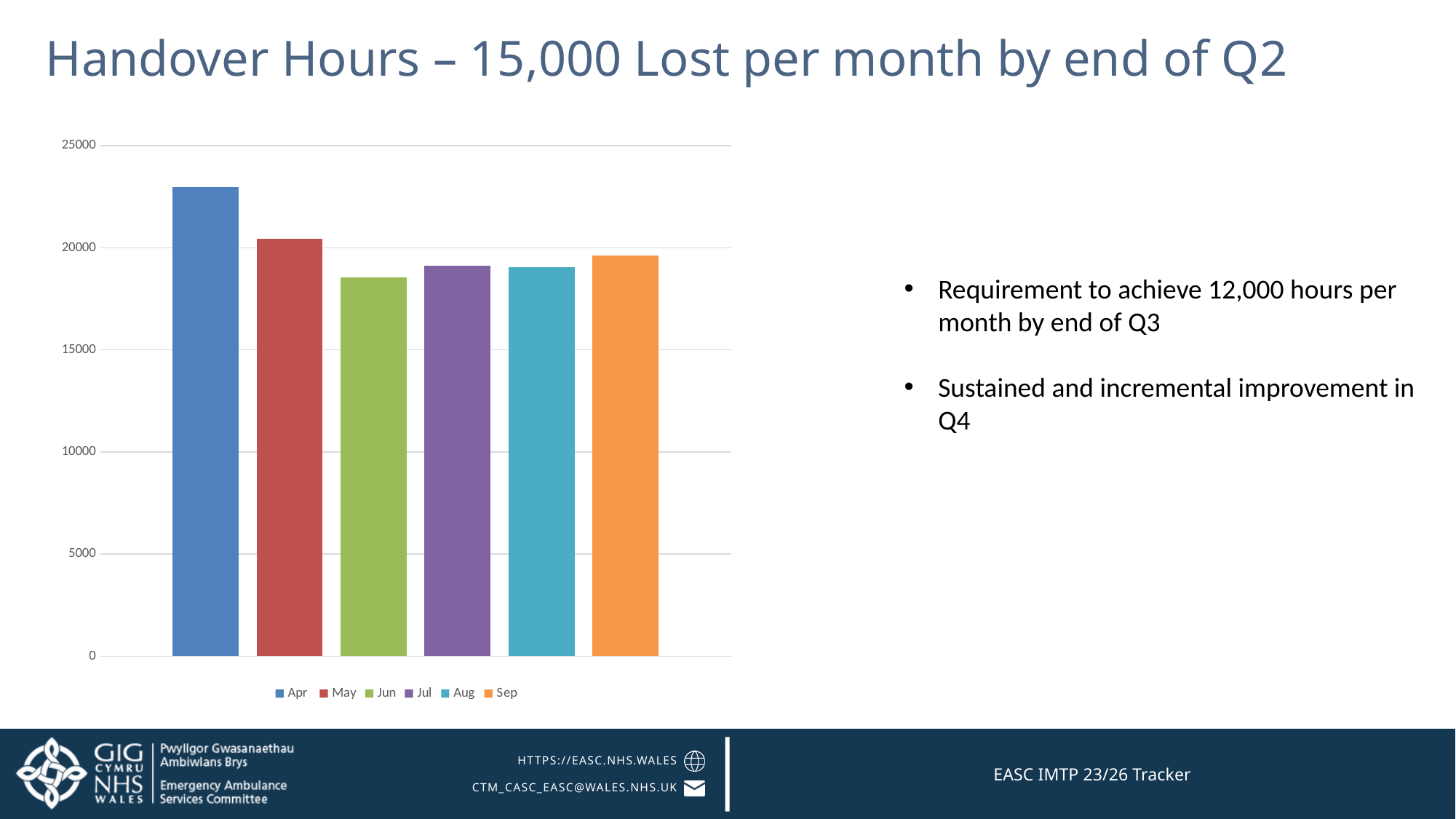
What colour is the bar for Sep in the chart? orange How many bars are plotted in the chart? 6 Do the values generally rise or fall from Apr to Sep? fall Is the value for Jun greater or less than 20000? less Which month has the lowest value in the chart? Jun Which month has the highest value in the chart? Apr Is the value for Jun greater or less than 15000? greater What kind of chart is shown on the slide? bar chart Which is larger, the value for May or the value for Jun? May How many entries does the chart legend list? 6 Is the value for Apr greater or less than 20000? greater Which is larger, the value for Apr or the value for Sep? Apr